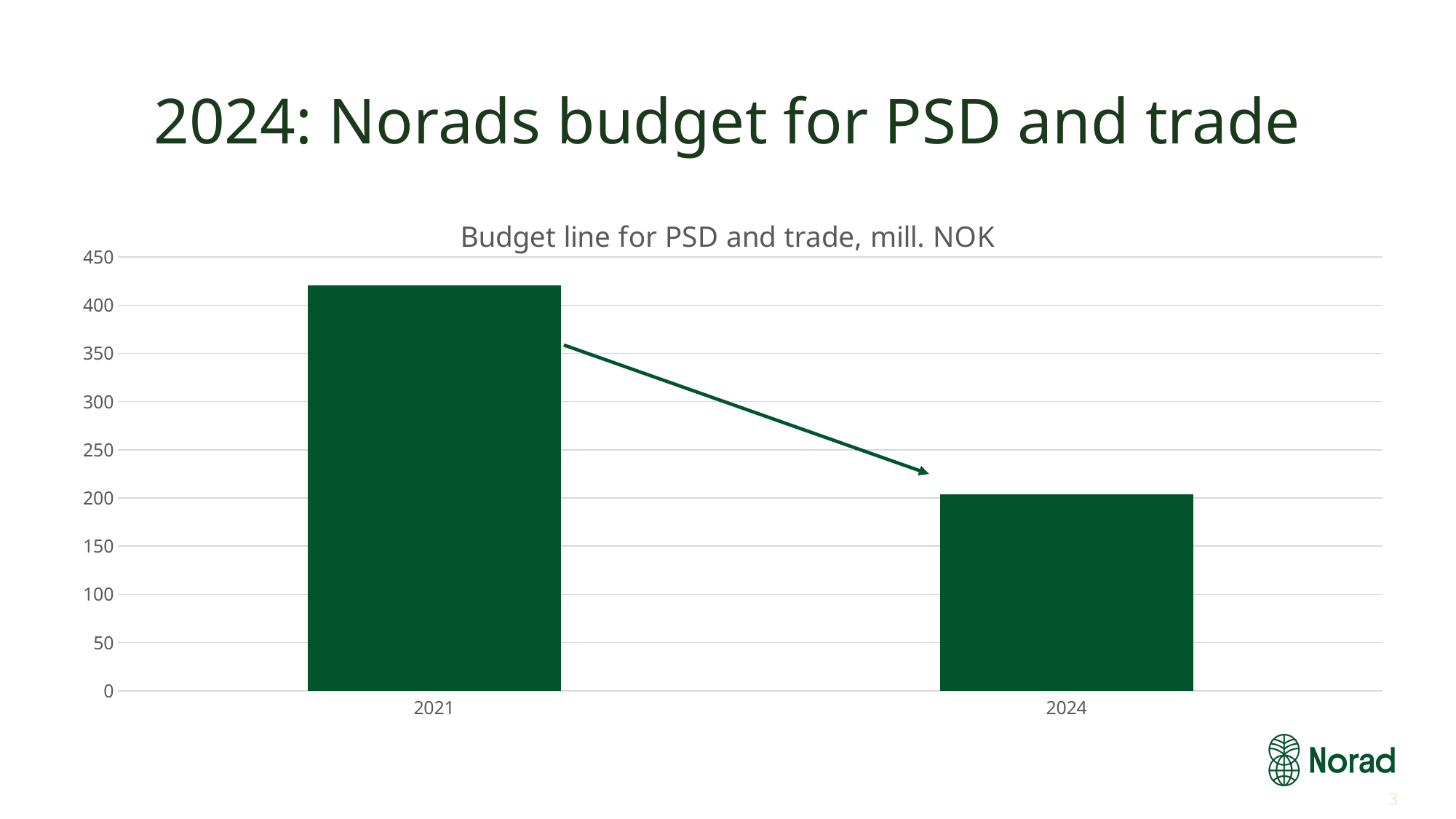
What is the title of the chart? Budget line for PSD and trade, mill. NOK Is the value for 2024 greater or less than 250? less Is the value for 2021 larger or smaller than the value for 2024? larger Which year has the higher budget line for PSD and trade? 2021 What kind of chart is shown on the slide? bar chart Is the value for 2021 greater or less than 450? less In what unit are the chart values expressed? mill. NOK Do the values rise or fall from 2021 to 2024? fall Which year has the lower budget line for PSD and trade? 2024 Is the value for 2024 greater or less than 150? greater How many bars (categories) does the chart show? 2